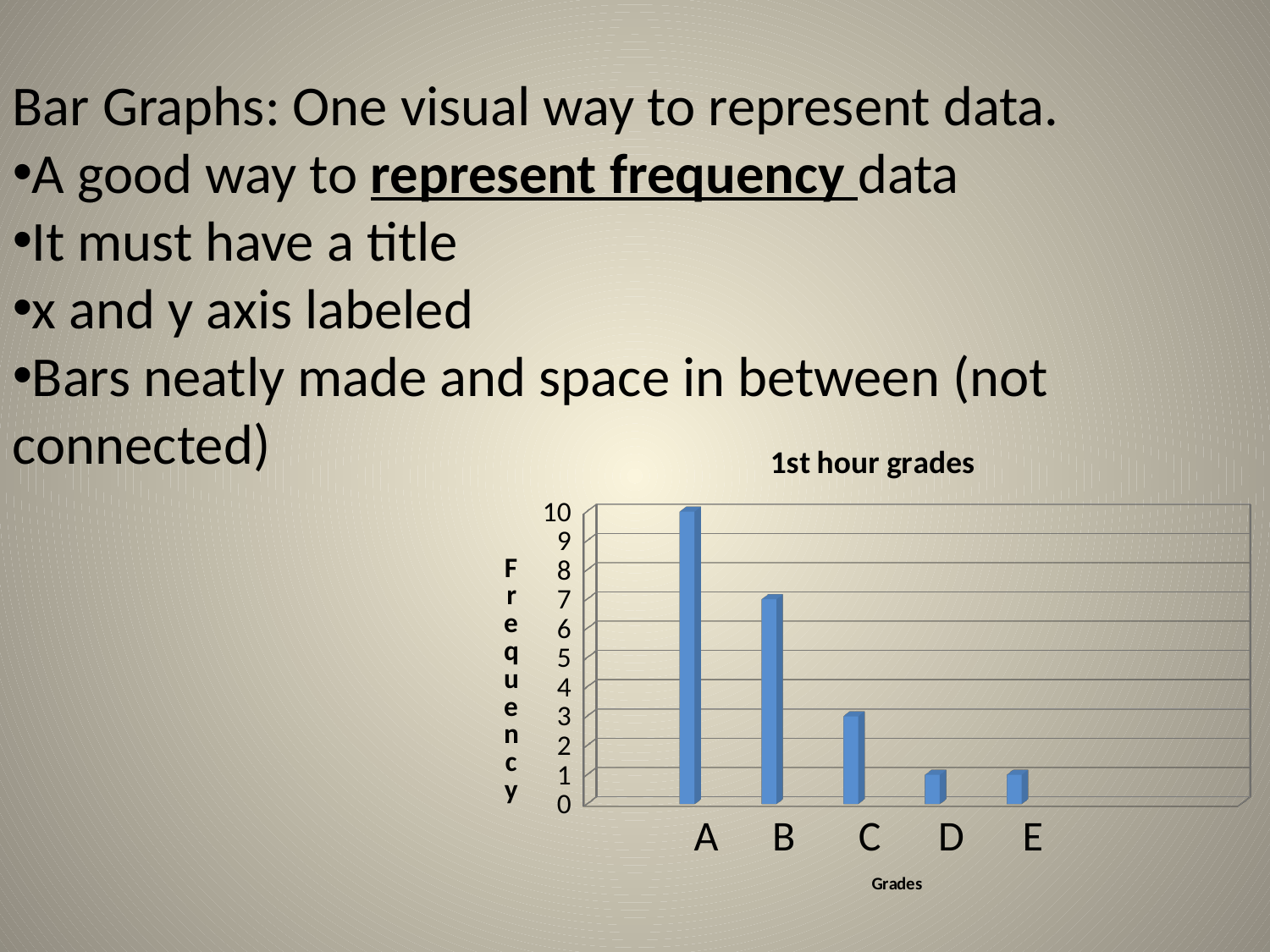
What type of chart is shown on the slide? bar chart What is the label on the x axis of the chart? Grades What is the difference in frequency between grade A and grade B? 3 What is the frequency for grade D? 1 Which grade has the highest frequency? A Which has a higher frequency, grade B or grade C? B What is the frequency for grade A? 10 What is the frequency for grade C? 3 Is the frequency for grade C greater or less than 5? less What is the frequency for grade B? 7 How many grade categories are shown on the x axis of the chart? 5 What is the title of the chart? 1st hour grades